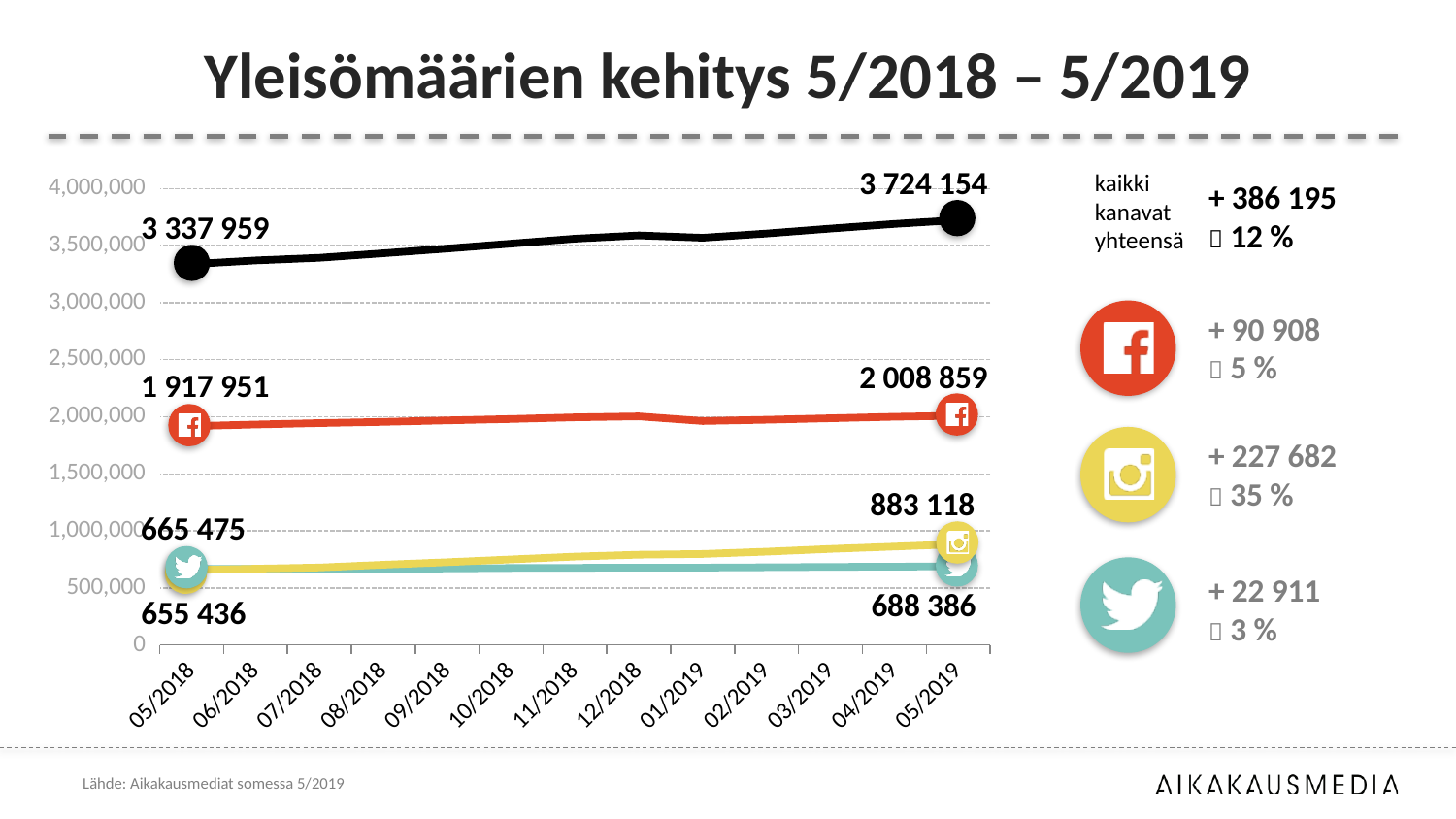
By how much did the Instagram line increase from 05/2018 to 05/2019? 227 682 What is the value of the Instagram line at 05/2019? 883 118 What is the value of the black (total) line at 05/2019? 3 724 154 Which line has the highest value at 05/2019? The black (total) line Is the Facebook value at 05/2018 greater or less than 2,000,000? less What is the value of the Facebook line at 05/2019? 2 008 859 What is the value of the Twitter line at 05/2018? 665 475 What is the value of the black (total) line at 05/2018? 3 337 959 At 05/2019, which is larger: the Instagram value or the Twitter value? Instagram How many months are shown on the x axis? 13 What kind of chart is shown on the slide? Line chart By how much did the Facebook line increase from 05/2018 to 05/2019? 90 908